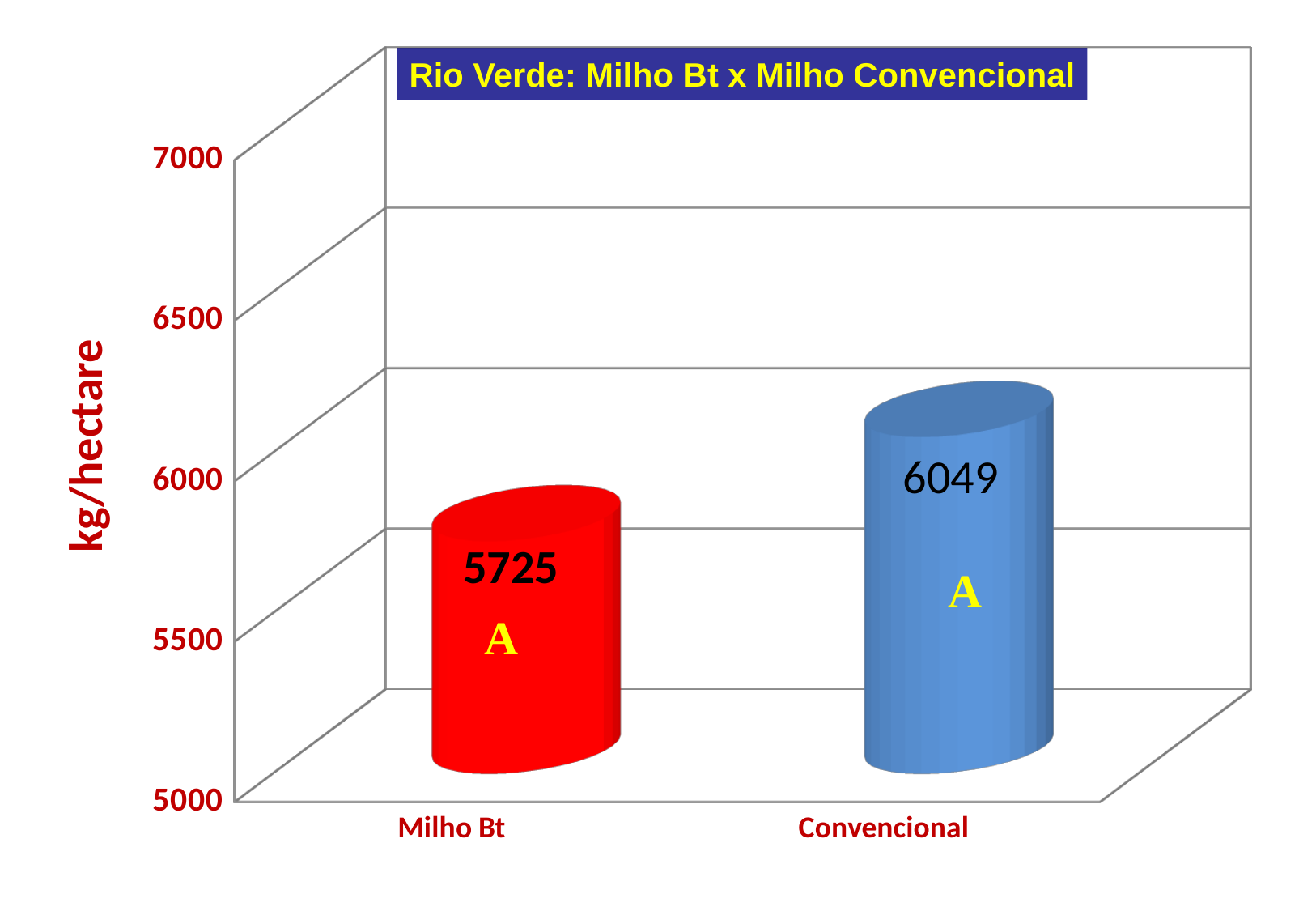
What is the value for Milho Bt? 5725 What is the difference between the values for Convencional and Milho Bt? 324 Which category has the lowest value? Milho Bt Which is larger, the value for Milho Bt or the value for Convencional? Convencional How many categories are shown on the chart? 2 What is the value for Convencional? 6049 What kind of chart is this? bar chart Is the value for Milho Bt greater or less than 6000? less What is the label on the vertical axis? kg/hectare Is the value for Convencional greater or less than 6000? greater Which category has the highest value? Convencional What is the title of the chart? Rio Verde: Milho Bt x Milho Convencional